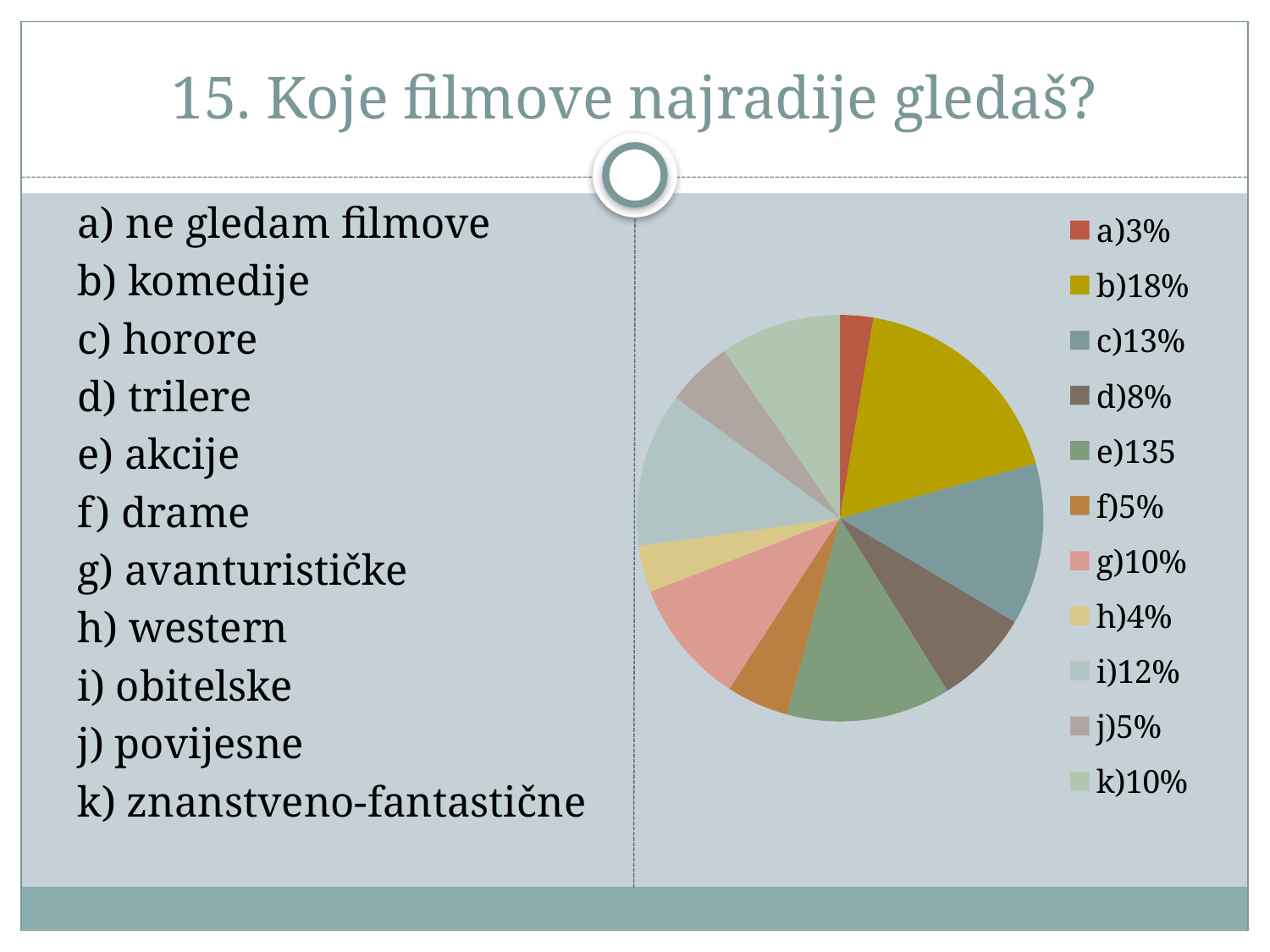
What kind of chart is shown on the slide? pie chart What percentage is shown in the legend for category c)? 13% Which category has the largest slice of the pie chart? b) What percentage is shown in the legend for category b)? 18% What is the difference between the percentages for b) and c)? 5% What is the title of the slide containing the pie chart? 15. Koje filmove najradije gledaš? How many slices does the pie chart have? 11 What share of the pie does category d) represent? 8% Which category has the smallest slice of the pie chart? a) What percentage is shown in the legend for category i)? 12% Which is larger, the slice for g) or the slice for h)? g) What percentage is shown in the legend for category h)? 4%